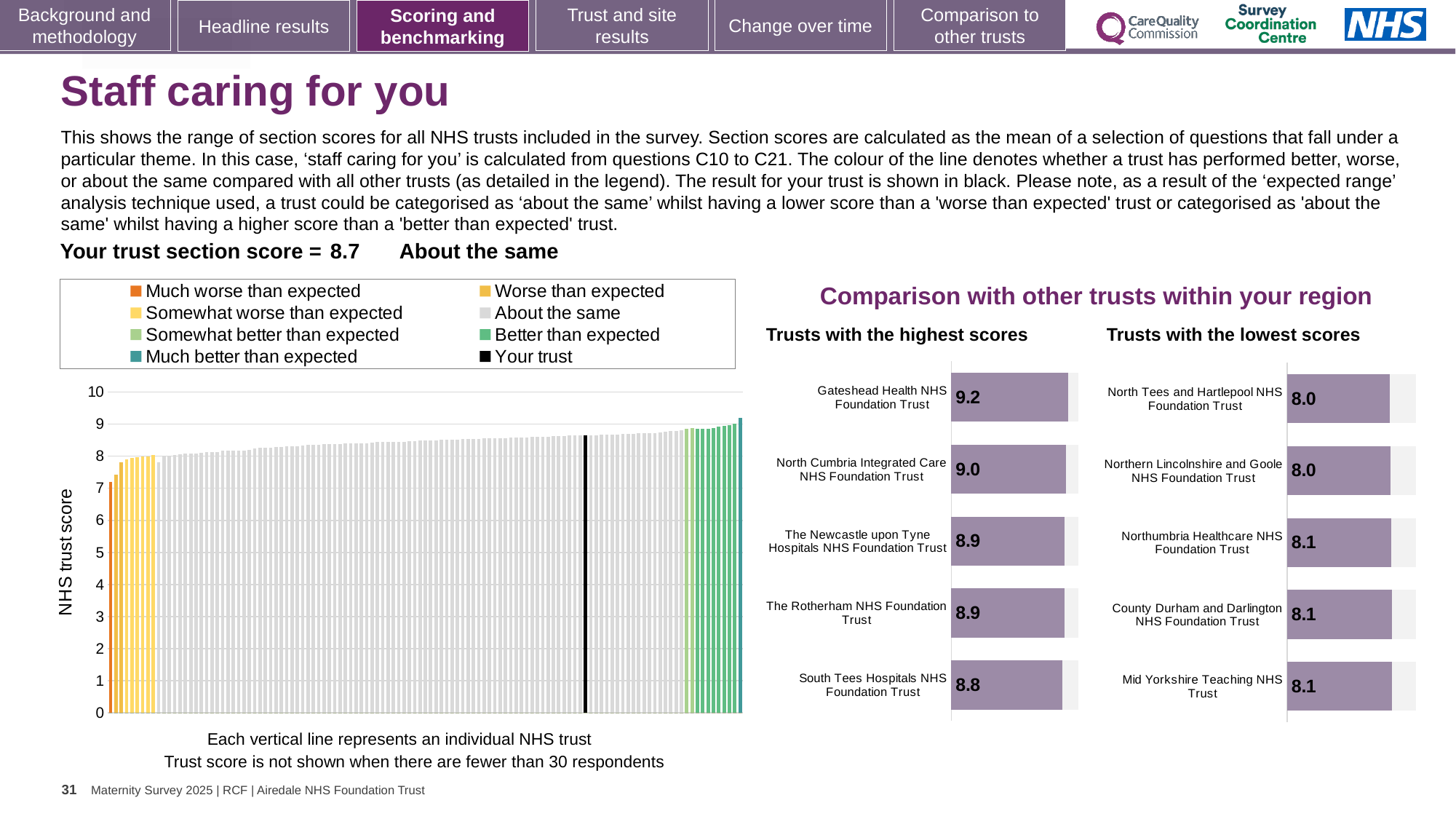
In the main chart on the left, is the value for your trust (the black bar) greater or less than 8? greater In the 'Trusts with the highest scores' chart, what is the score for Gateshead Health NHS Foundation Trust? 9.2 In the 'Trusts with the highest scores' chart, what is the score for South Tees Hospitals NHS Foundation Trust? 8.8 In the 'Trusts with the highest scores' chart, which trust has the highest score? Gateshead Health NHS Foundation Trust How many trusts are shown in the 'Trusts with the highest scores' chart? 5 In the 'Trusts with the lowest scores' chart, which has the larger score: Northumbria Healthcare NHS Foundation Trust or North Tees and Hartlepool NHS Foundation Trust? Northumbria Healthcare NHS Foundation Trust In the 'Trusts with the lowest scores' chart, what is the difference between the scores of County Durham and Darlington NHS Foundation Trust and Northern Lincolnshire and Goole NHS Foundation Trust? 0.1 In the 'Trusts with the highest scores' chart, what is the difference between the scores of Gateshead Health NHS Foundation Trust and South Tees Hospitals NHS Foundation Trust? 0.4 What kind of chart is the main chart on the left showing NHS trust scores? Bar chart In the 'Trusts with the lowest scores' chart, what is the score for Mid Yorkshire Teaching NHS Trust? 8.1 How many entries does the legend of the main 'NHS trust score' chart on the left list? 8 In the 'Trusts with the lowest scores' chart, what is the score for North Tees and Hartlepool NHS Foundation Trust? 8.0